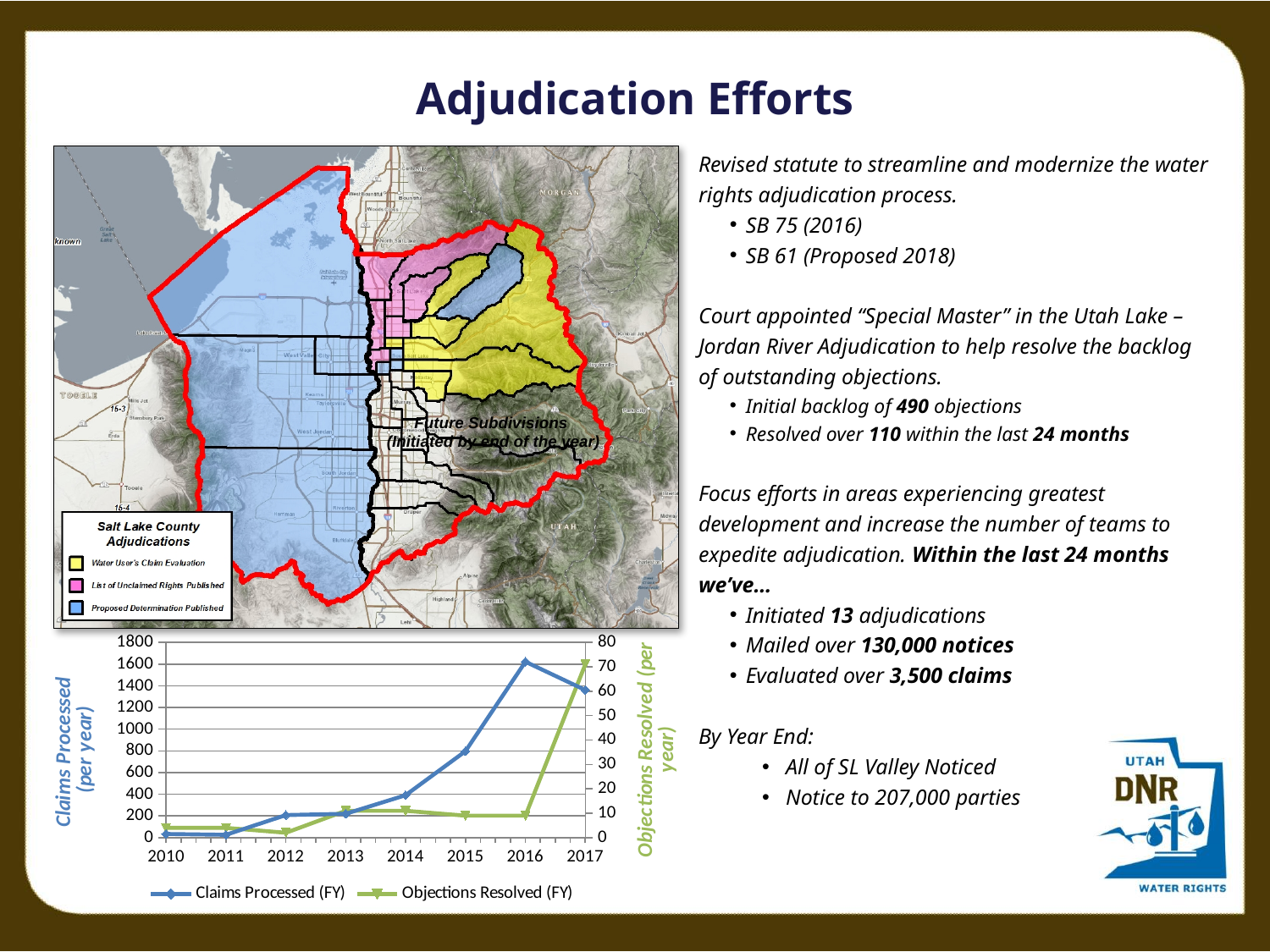
How many years are plotted along the x axis of the line chart? 8 Which year has the larger Claims Processed (FY) value, 2016 or 2017? 2016 Is the Claims Processed (FY) value for 2016 greater or less than 1400? greater Is the Claims Processed (FY) value for 2014 greater or less than 600? less Is the Objections Resolved (FY) value for 2017 greater or less than 60? greater How many series does the legend of the line chart list? 2 Does the Claims Processed (FY) series generally rise or fall from 2010 to 2016? rise In which year is the Objections Resolved (FY) value highest? 2017 What is the title of the right-hand vertical axis of the line chart? Objections Resolved (per year) What kind of chart is shown at the bottom left of the slide? line chart In which year is the Claims Processed (FY) value highest? 2016